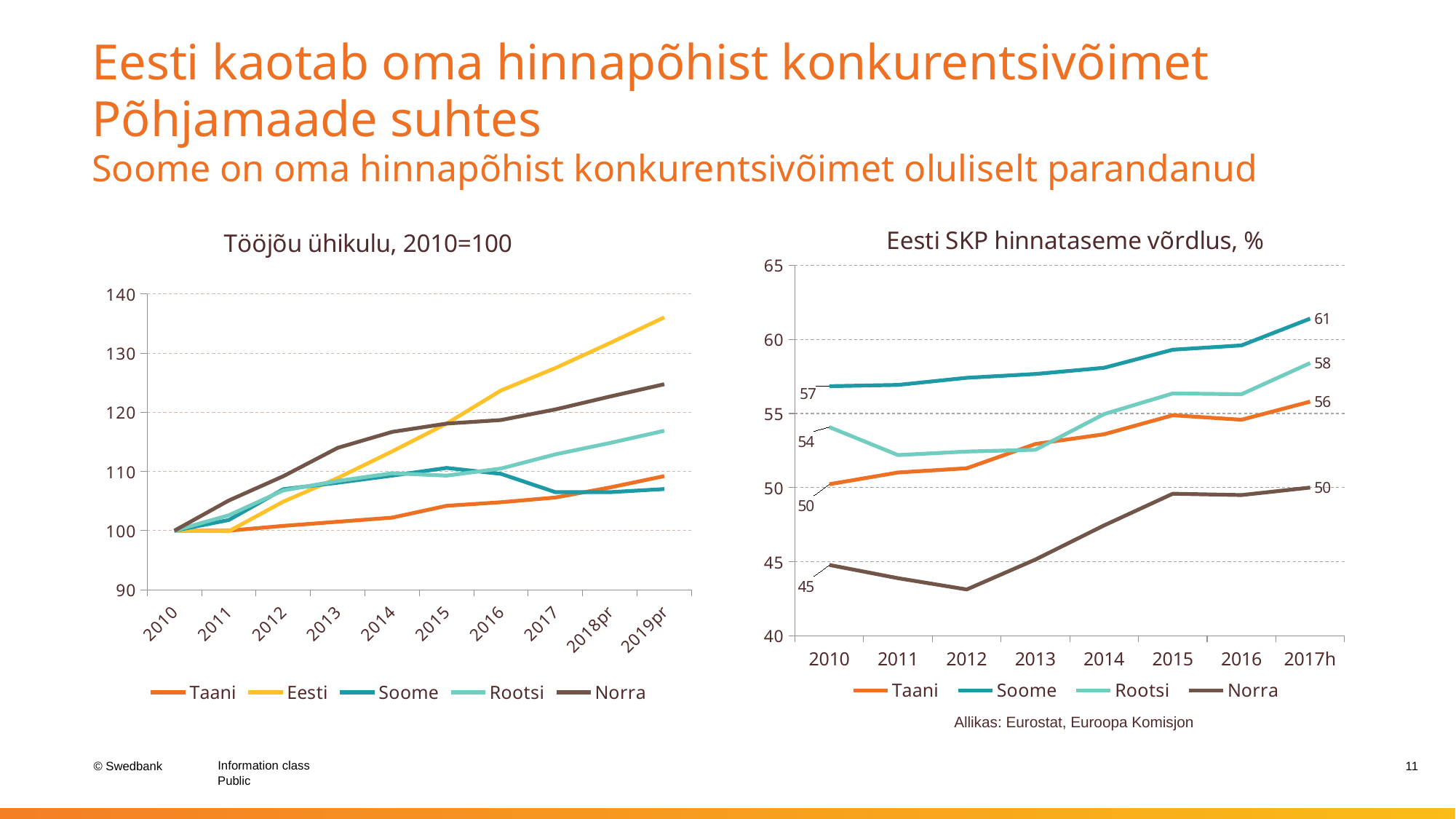
In the chart titled "Eesti SKP hinnataseme võrdlus, %", how many series does the legend list? 4 In the chart titled "Eesti SKP hinnataseme võrdlus, %", which series has the lowest value in 2010? Norra What kind of chart is the chart titled "Tööjõu ühikulu, 2010=100"? Line chart In the chart titled "Tööjõu ühikulu, 2010=100", how many series does the legend list? 5 In the chart titled "Tööjõu ühikulu, 2010=100", which series has the highest value in 2019pr? Eesti In the chart titled "Eesti SKP hinnataseme võrdlus, %", by how much did the value for Taani increase from 2010 to 2017h? 6 In the chart titled "Tööjõu ühikulu, 2010=100", how many years are shown on the x axis? 10 In the chart titled "Eesti SKP hinnataseme võrdlus, %", what is the value for Soome in 2017h? 61 In the chart titled "Tööjõu ühikulu, 2010=100", is the value for Eesti in 2019pr greater or less than 130? greater In the chart titled "Eesti SKP hinnataseme võrdlus, %", is the value for Rootsi in 2017h larger than the value for Taani in 2017h? Yes, Rootsi (58) is larger than Taani (56) In the chart titled "Eesti SKP hinnataseme võrdlus, %", what is the value for Norra in 2010? 45 In the chart titled "Eesti SKP hinnataseme võrdlus, %", which series has the highest value in 2017h? Soome